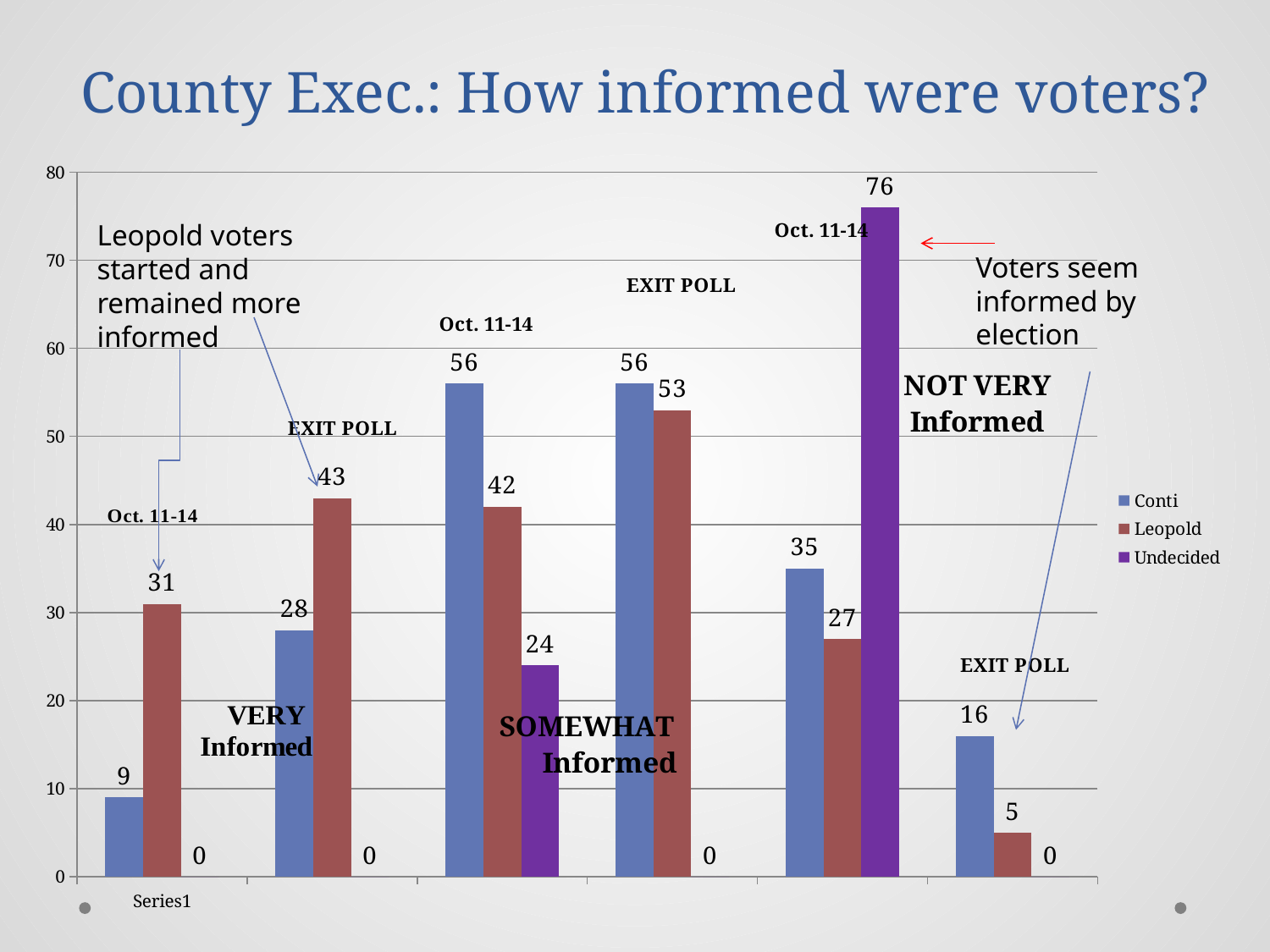
Which series has the highest value in the Not Very Informed Oct. 11-14 group? Undecided What is the Undecided value in the Not Very Informed Oct. 11-14 group? 76 Which series has the lowest value in the Very Informed Exit Poll group? Undecided How many series does the legend list? 3 What is the Leopold value in the Very Informed Oct. 11-14 group? 31 What is the difference between the Leopold and Conti values in the Very Informed Exit Poll group? 15 What type of chart is shown on the slide? bar chart What is the Leopold value in the Not Very Informed Exit Poll group? 5 What is the title of the slide? County Exec.: How informed were voters? What is the Conti value in the Very Informed Exit Poll group? 28 What is the highest value shown on the vertical axis? 80 In the Somewhat Informed Oct. 11-14 group, which is larger, the Conti value or the Leopold value? Conti